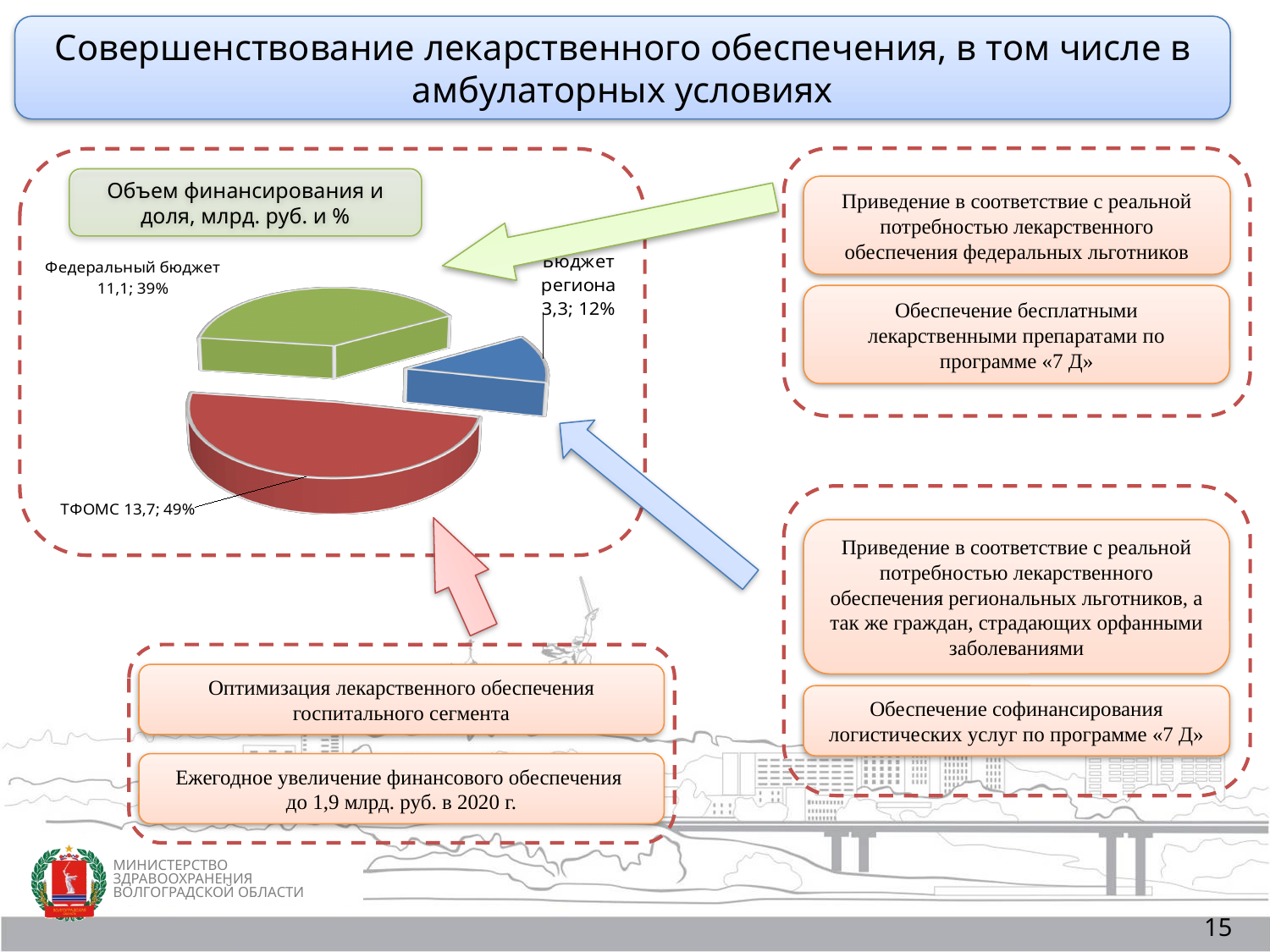
Which slice of the pie chart is the largest? ТФОМС Which slice of the pie chart is the smallest? Бюджет региона What share of the pie does ТФОМС account for? 49% What is the value for ТФОМС in the pie chart? 13,7 What is the difference between the values for ТФОМС and Федеральный бюджет? 2,6 How many slices does the pie chart have? 3 What is the value for Бюджет региона in the pie chart? 3,3 What type of chart is shown on the slide? Pie chart What share of the pie does Федеральный бюджет account for? 39% What is the title of the pie chart? Объем финансирования и доля, млрд. руб. и % What is the value for Федеральный бюджет in the pie chart? 11,1 What share of the pie does Бюджет региона account for? 12%